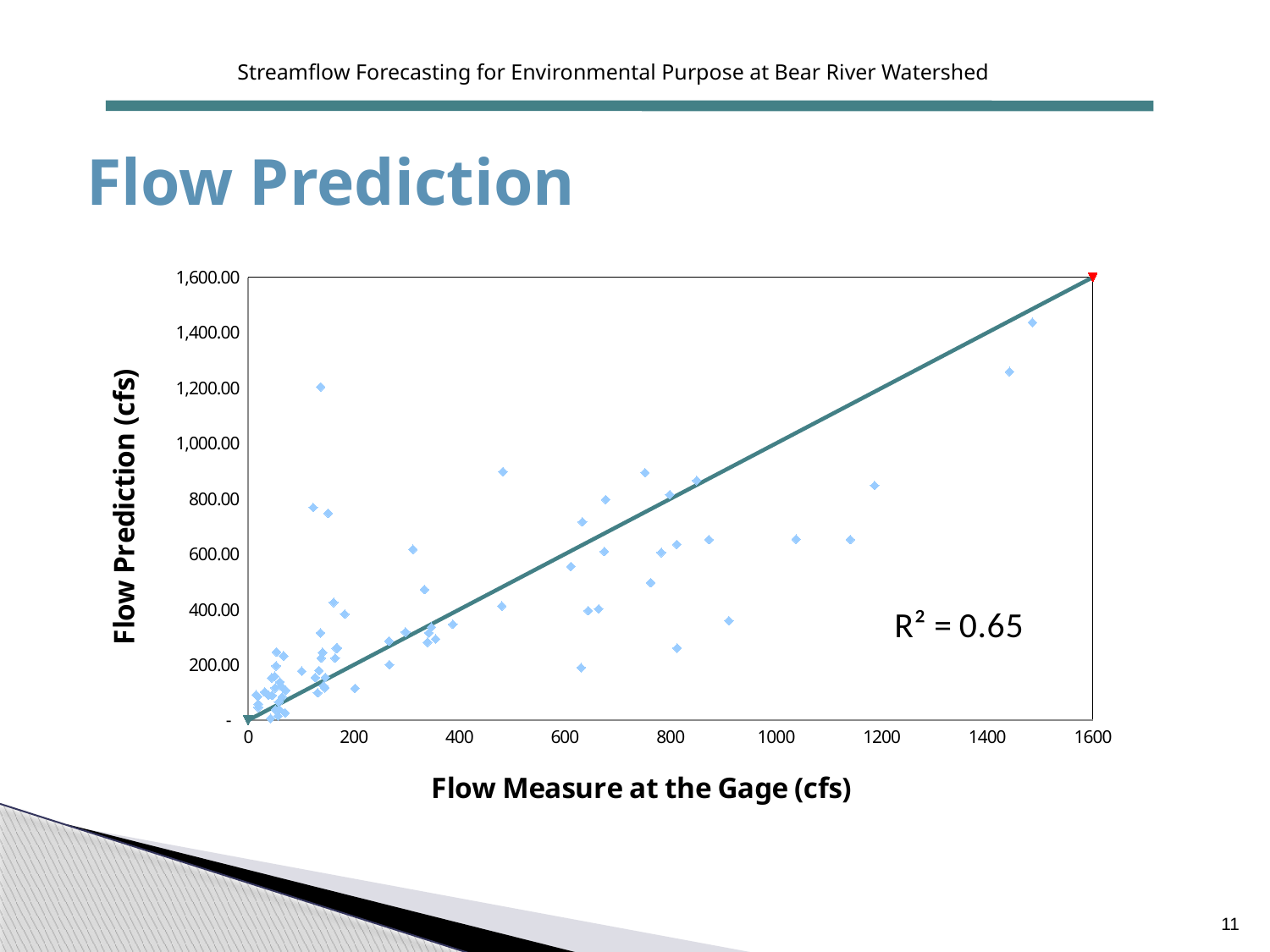
What R² value is printed on the chart? R² = 0.65 What is the highest tick value shown on the y axis? 1,600.00 What is the highest tick value shown on the x axis? 1600 What kind of chart is shown on the slide? scatter plot What is the title of the y axis? Flow Prediction (cfs) Is the predicted flow for the point with the highest measured flow (near 1500 cfs) greater or less than 1,600.00? less Is the predicted flow for the point with the highest measured flow (near 1500 cfs) greater or less than 1,200.00? greater At what x-axis value does the straight line drawn through the points end? 1600 Is the R² value shown on the chart greater or less than 0.5? greater Do the plotted points generally rise or fall as the flow measured at the gage increases? rise What is the title of the x axis? Flow Measure at the Gage (cfs)